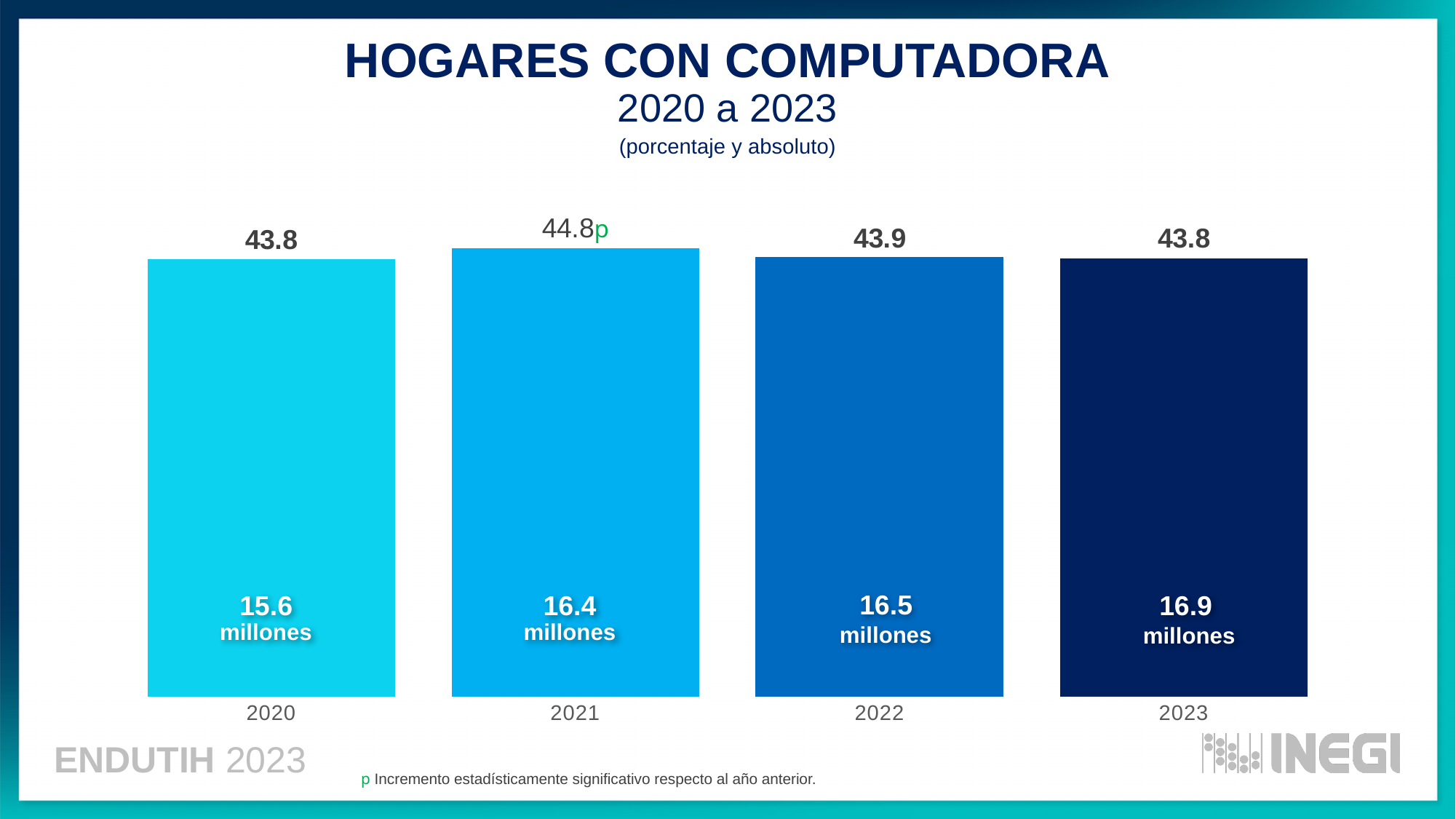
What kind of chart is shown on the slide? Bar chart What is the difference in percentage points between 2021 and 2020? 1.0 Which year has the lowest absolute number of households with a computer? 2020 How many millions of households had a computer in 2023? 16.9 millones Do the absolute numbers of households with a computer rise or fall from 2020 to 2023? Rise What percentage of households had a computer in 2021? 44.8 How many years are shown in the chart? 4 Which year has the highest absolute number of households with a computer? 2023 What is the difference in millions of households between 2023 and 2020? 1.3 millones Which year has the highest percentage of households with a computer? 2021 Which year has more households with a computer in absolute terms, 2021 or 2022? 2022 What percentage is shown for 2020? 43.8